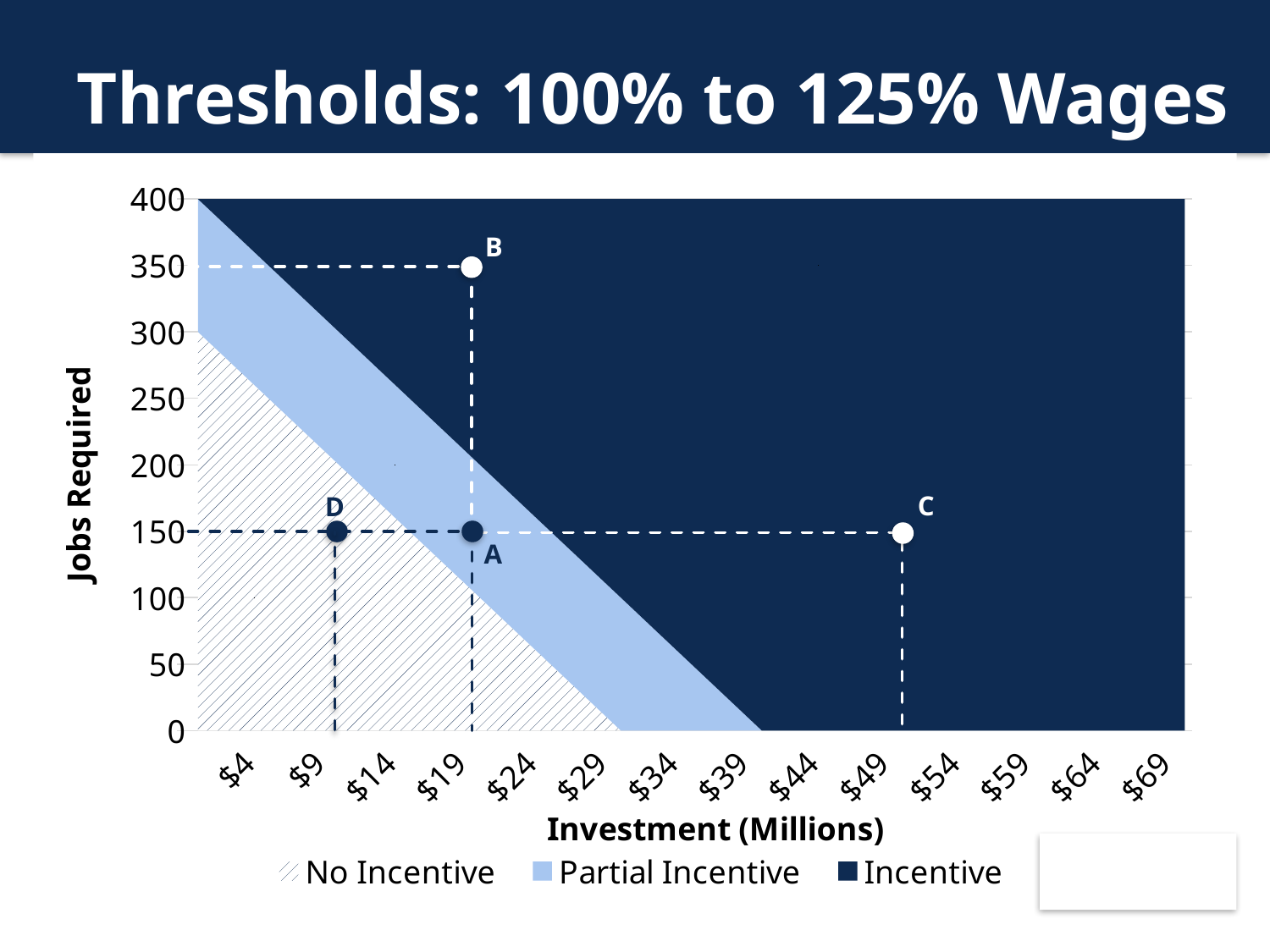
What are the three legend entries on the chart? No Incentive, Partial Incentive, Incentive Is the investment for point D greater or less than $14 million? less Which incentive region does point D fall in? No Incentive Which labelled point has the highest number of jobs required? B What is the title of the chart? Thresholds: 100% to 125% Wages How many jobs are required at point C? 150 How many jobs are required at point A? 150 How many entries does the chart legend list? 3 What kind of chart is shown on the slide? area chart Is the investment for point C greater or less than $44 million? greater What is the difference in jobs required between point B and point A? 200 How many jobs are required at point B? 350